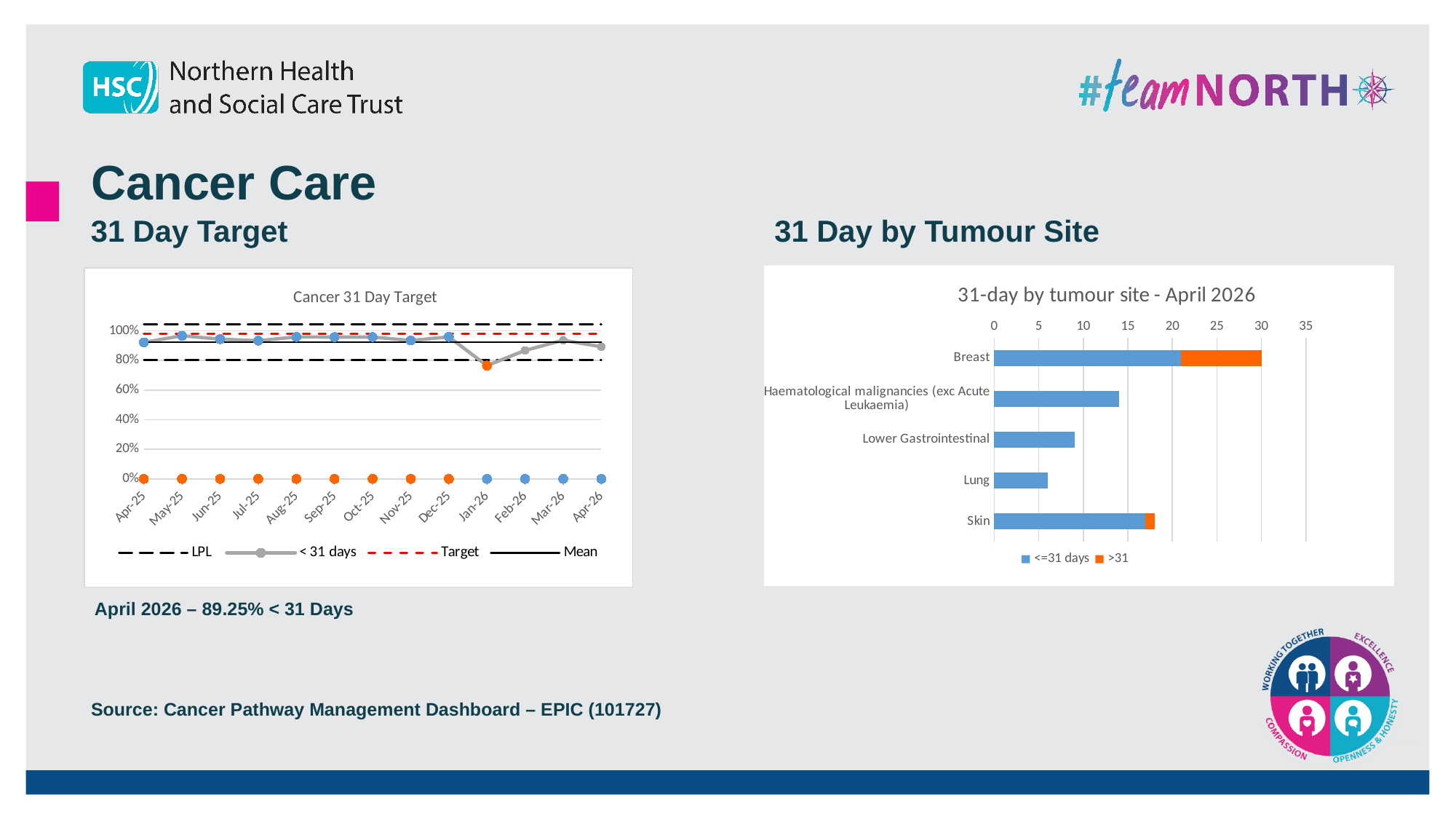
In the '31-day by tumour site - April 2026' chart, is the total bar for Breast greater or less than 25? greater What kind of chart is the 'Cancer 31 Day Target' chart? line chart In the '31-day by tumour site - April 2026' chart, which tumour site has the longest total bar? Breast How many series does the legend of the '31-day by tumour site - April 2026' chart list? 2 In the '31-day by tumour site - April 2026' chart, which tumour site has the shortest bar? Lung In the 'Cancer 31 Day Target' chart, is the '< 31 days' value for Jan-26 greater or less than 80%? less How many tumour site categories are shown in the '31-day by tumour site - April 2026' chart? 5 In the '31-day by tumour site - April 2026' chart, which bar is longer: Lower Gastrointestinal or Lung? Lower Gastrointestinal In the '31-day by tumour site - April 2026' chart, is the value for Haematological malignancies (exc Acute Leukaemia) greater or less than 10? greater How many months are plotted along the x axis of the 'Cancer 31 Day Target' chart? 13 What kind of chart is the '31-day by tumour site - April 2026' chart? bar chart How many series does the legend of the 'Cancer 31 Day Target' chart list? 4